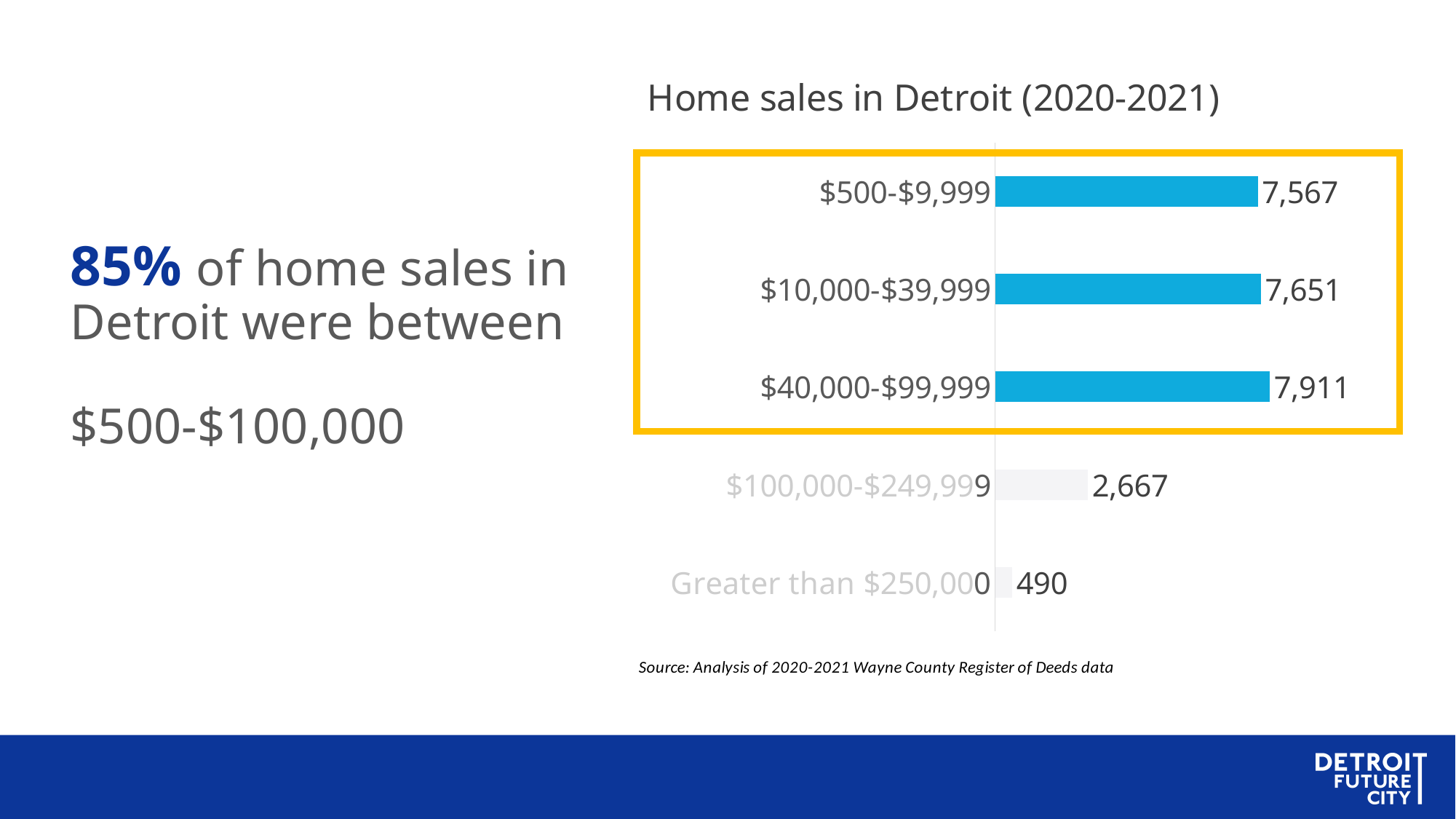
Which has more home sales: the $500-$9,999 range or the $10,000-$39,999 range? $10,000-$39,999 What is the number of home sales in the $10,000-$39,999 price range? 7,651 Which price range has the lowest number of home sales? Greater than $250,000 What is the number of home sales in the $40,000-$99,999 price range? 7,911 What is the number of home sales in the $100,000-$249,999 price range? 2,667 What is the number of home sales for homes priced greater than $250,000? 490 What is the number of home sales in the $500-$9,999 price range? 7,567 What is the title of the chart? Home sales in Detroit (2020-2021) Which price range has the highest number of home sales? $40,000-$99,999 What type of chart is shown on the slide? Bar chart What is the difference in home sales between the $40,000-$99,999 range and the $100,000-$249,999 range? 5,244 How many price range categories are shown in the chart? 5